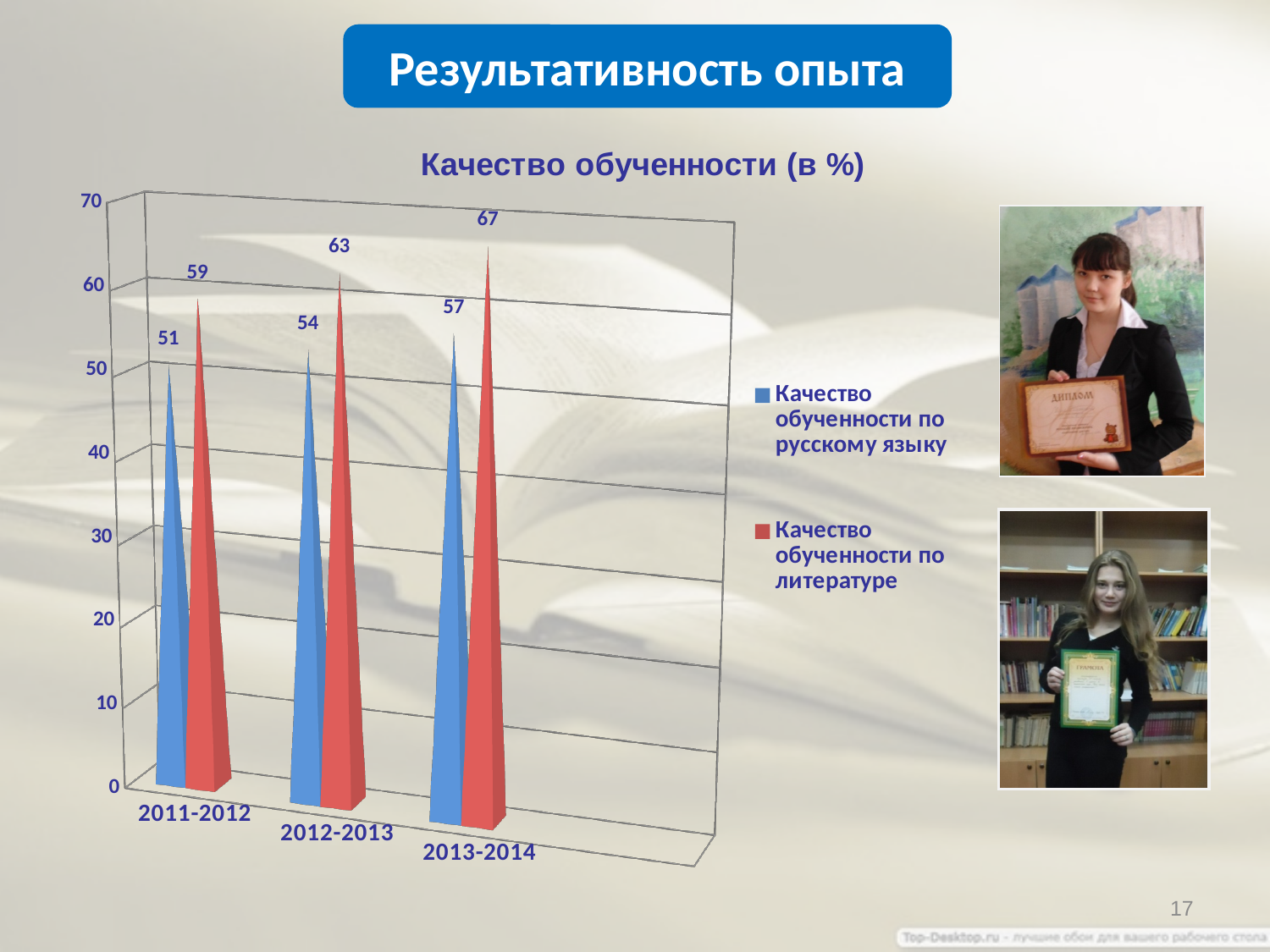
What kind of chart is shown on the slide? Bar chart In which year is Качество обученности по русскому языку lowest? 2011-2012 Do the values for Качество обученности по русскому языку rise or fall from 2011-2012 to 2013-2014? Rise What is the difference between Качество обученности по литературе and Качество обученности по русскому языку in 2012-2013? 9 How many series does the legend list? 2 What is the value for Качество обученности по русскому языку in 2011-2012? 51 What is the value for Качество обученности по русскому языку in 2013-2014? 57 In which year is Качество обученности по литературе highest? 2013-2014 What is the value for Качество обученности по литературе in 2012-2013? 63 What is the value for Качество обученности по литературе in 2013-2014? 67 How many year categories are shown on the x axis? 3 Which is larger in 2011-2012: Качество обученности по русскому языку or Качество обученности по литературе? Качество обученности по литературе